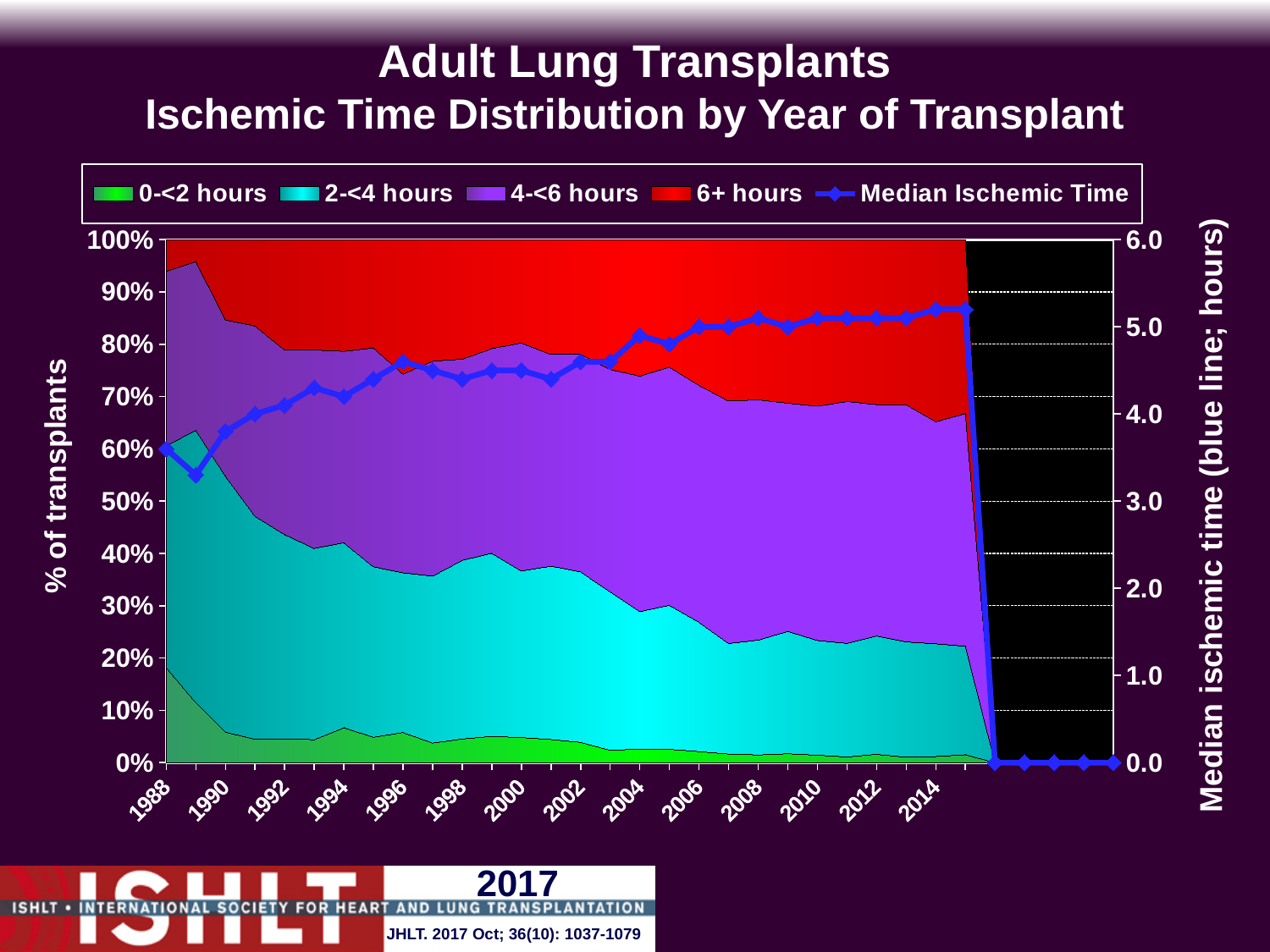
What is the maximum value shown on the right-hand axis? 6.0 Is the share of transplants with 6+ hours ischemic time in 2014 greater or less than 20%? greater Is the median ischemic time in 1988 greater or less than 3.0 hours? greater Is the median ischemic time in 2014 greater or less than 4.0 hours? greater What is the title of the chart? Adult Lung Transplants Ischemic Time Distribution by Year of Transplant Does the median ischemic time generally rise or fall from 1988 to 2014? rise Which year has the larger median ischemic time, 1992 or 2004? 2004 What kind of chart is this? Stacked area chart with a line How many series does the legend list? 5 Which series is plotted as the blue line with diamond markers? Median Ischemic Time